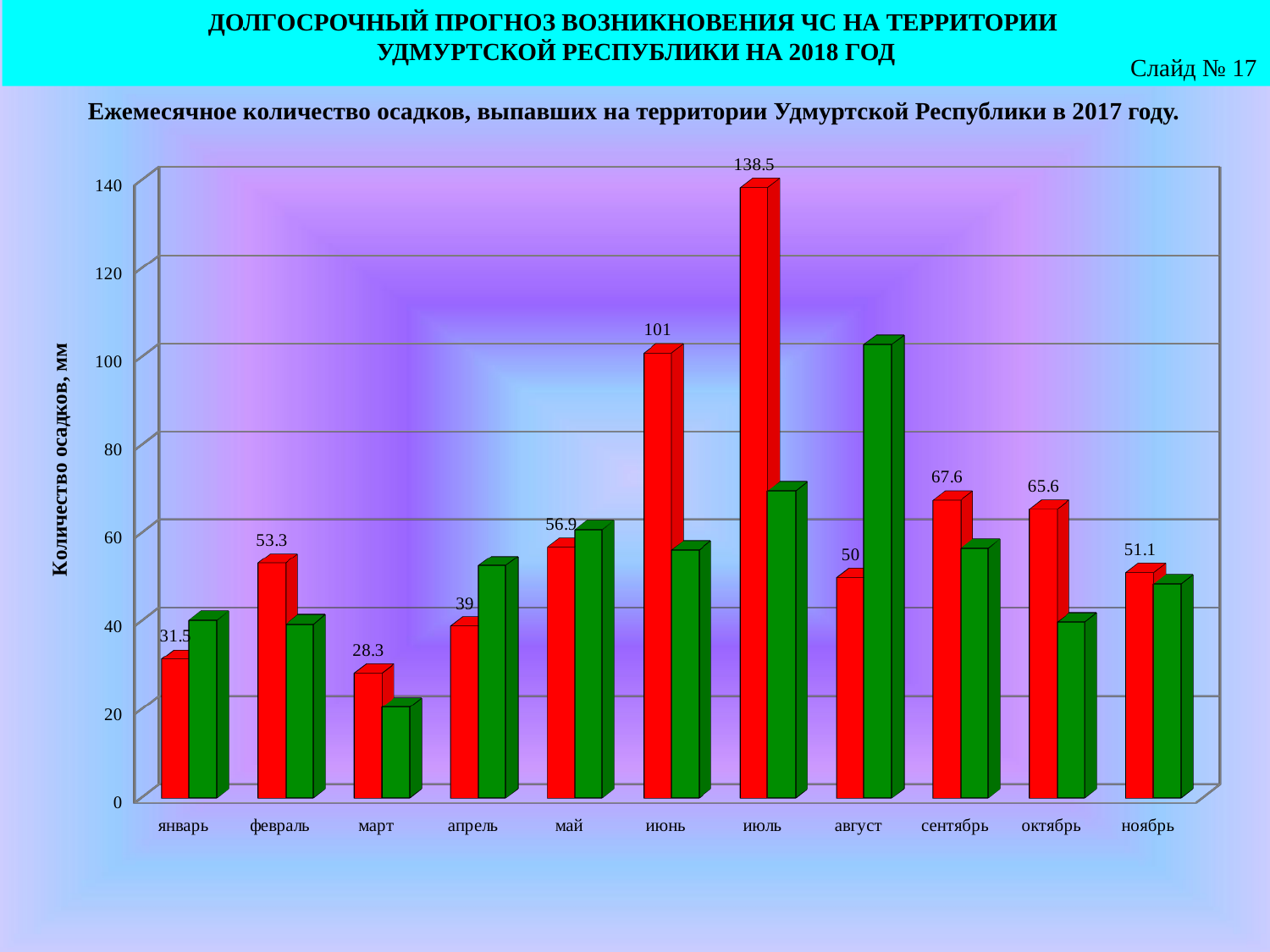
Which month has the lowest red bar? март How many months are shown on the x axis? 11 Is the green bar for апрель greater or less than 40? greater What is the value of the red bar for июль? 138.5 What kind of chart is shown on the slide? bar chart Which month has the highest red bar? июль What is the value of the red bar for сентябрь? 67.6 What is the difference between the red bar values for июль and июнь? 37.5 Is the green bar for август greater or less than 100? greater What is the value of the red bar for март? 28.3 Which month has the larger red bar value, сентябрь or октябрь? сентябрь What is the title of the y axis? Количество осадков, мм